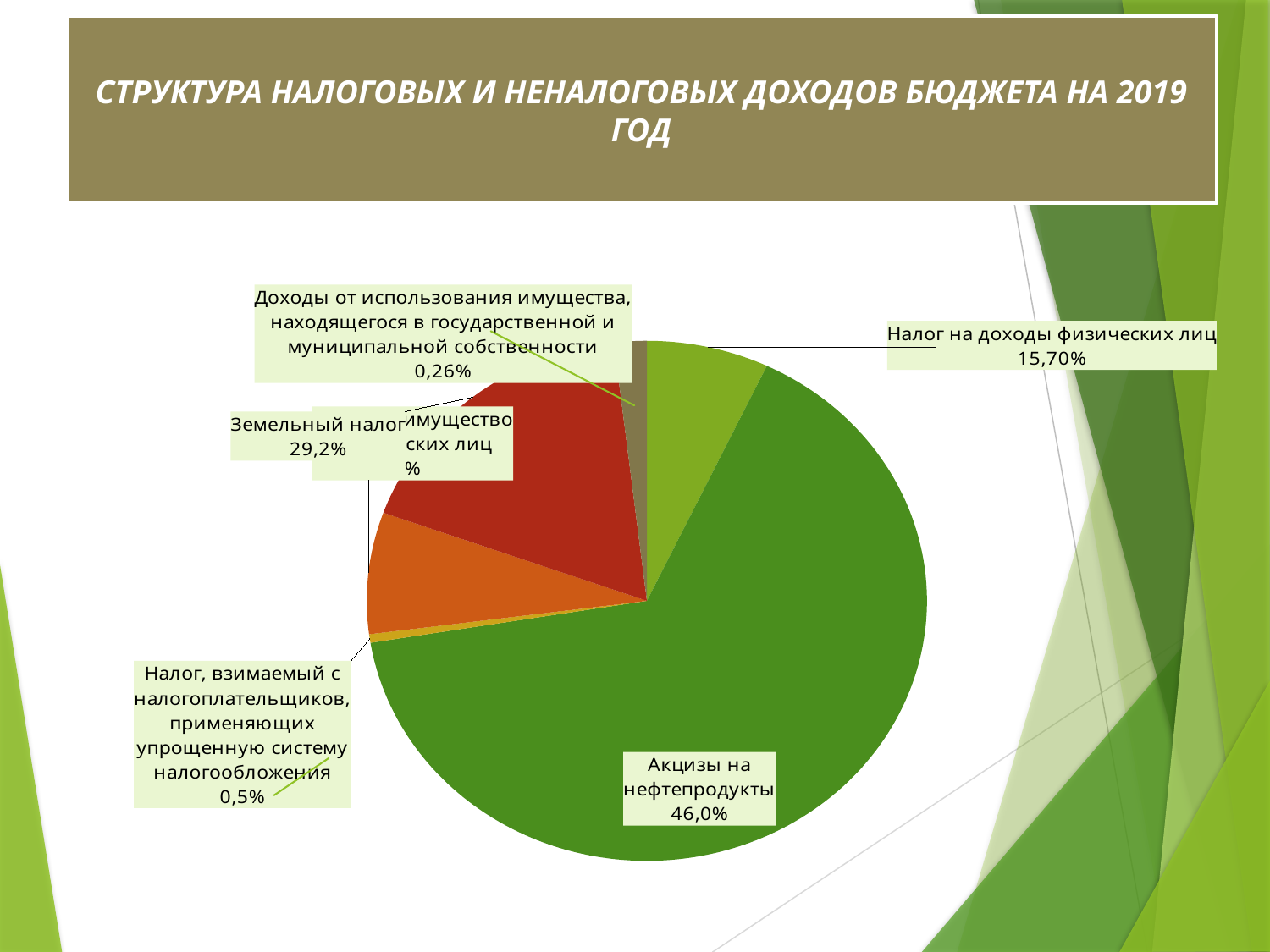
What is the title of the slide? СТРУКТУРА НАЛОГОВЫХ И НЕНАЛОГОВЫХ ДОХОДОВ БЮДЖЕТА НА 2019 ГОД What is the difference in percentage points between "Акцизы на нефтепродукты" and "Налог на доходы физических лиц"? 30,3 What is the value shown for "Налог на доходы физических лиц"? 15,70% Which is larger: "Земельный налог" or "Налог на доходы физических лиц"? Земельный налог What share of the pie does "Акцизы на нефтепродукты" have? 46,0% What is the value shown for "Земельный налог"? 29,2% What is the value shown for "Налог, взимаемый с налогоплательщиков, применяющих упрощенную систему налогообложения"? 0,5% How many slices does the pie chart have? 6 Which category has the largest share of the pie? Акцизы на нефтепродукты What kind of chart is shown on the slide? pie chart What is the value shown for "Доходы от использования имущества, находящегося в государственной и муниципальной собственности"? 0,26%